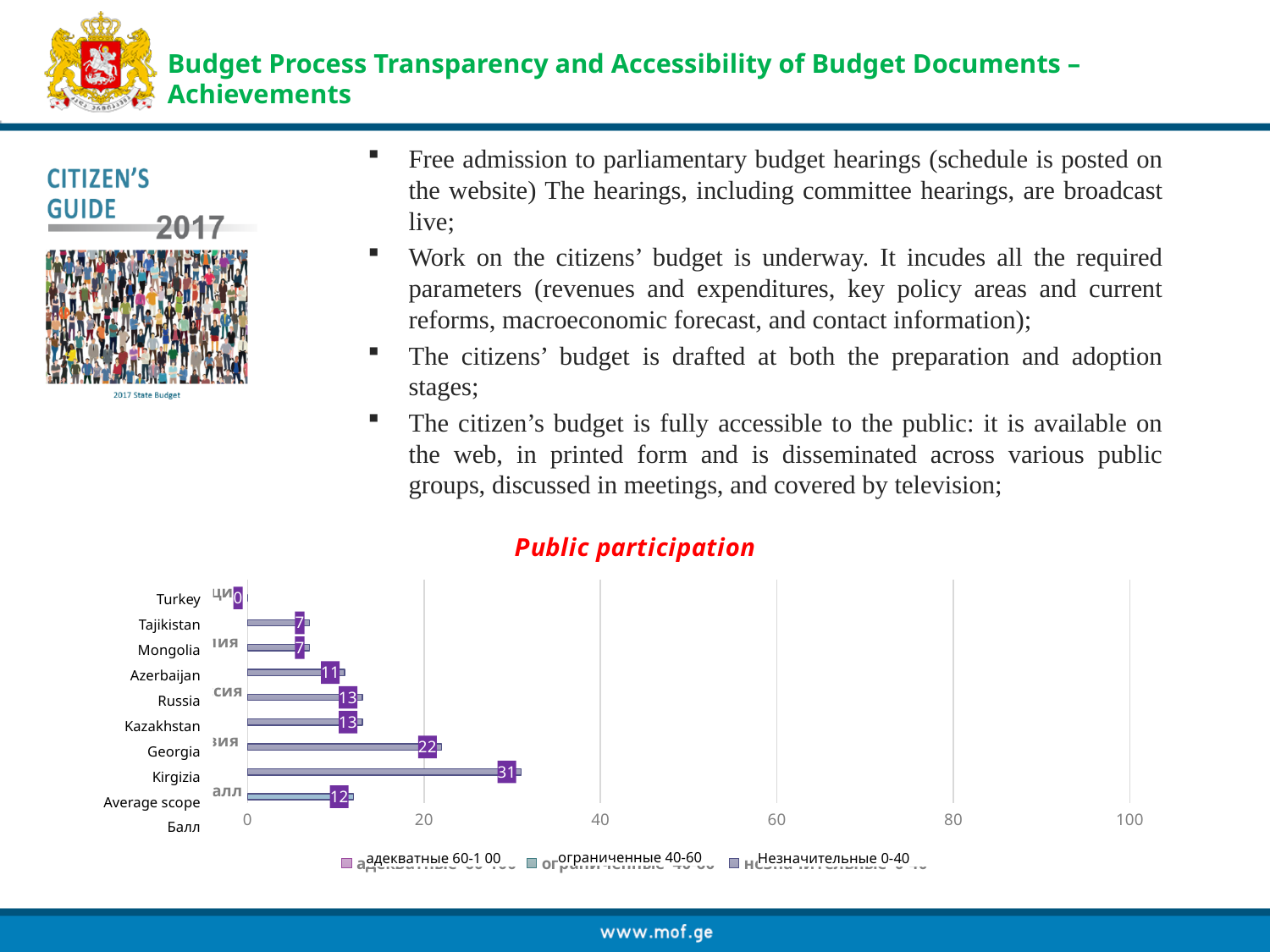
Which country has the lowest public participation value? Turkey Which has a higher public participation value, Georgia or Russia? Georgia How many countries are listed in the Public participation chart? 8 What is the public participation value for Azerbaijan? 11 What is the public participation value for Georgia? 22 What is the difference between the public participation values of Kirgizia and Georgia? 9 Which country has the highest public participation value? Kirgizia How many entries does the legend of the Public participation chart list? 3 What kind of chart is the Public participation chart? bar chart What is the value shown for Average scope in the Public participation chart? 12 Is the public participation value for Kirgizia greater or less than 40? less What is the public participation value for Kirgizia? 31